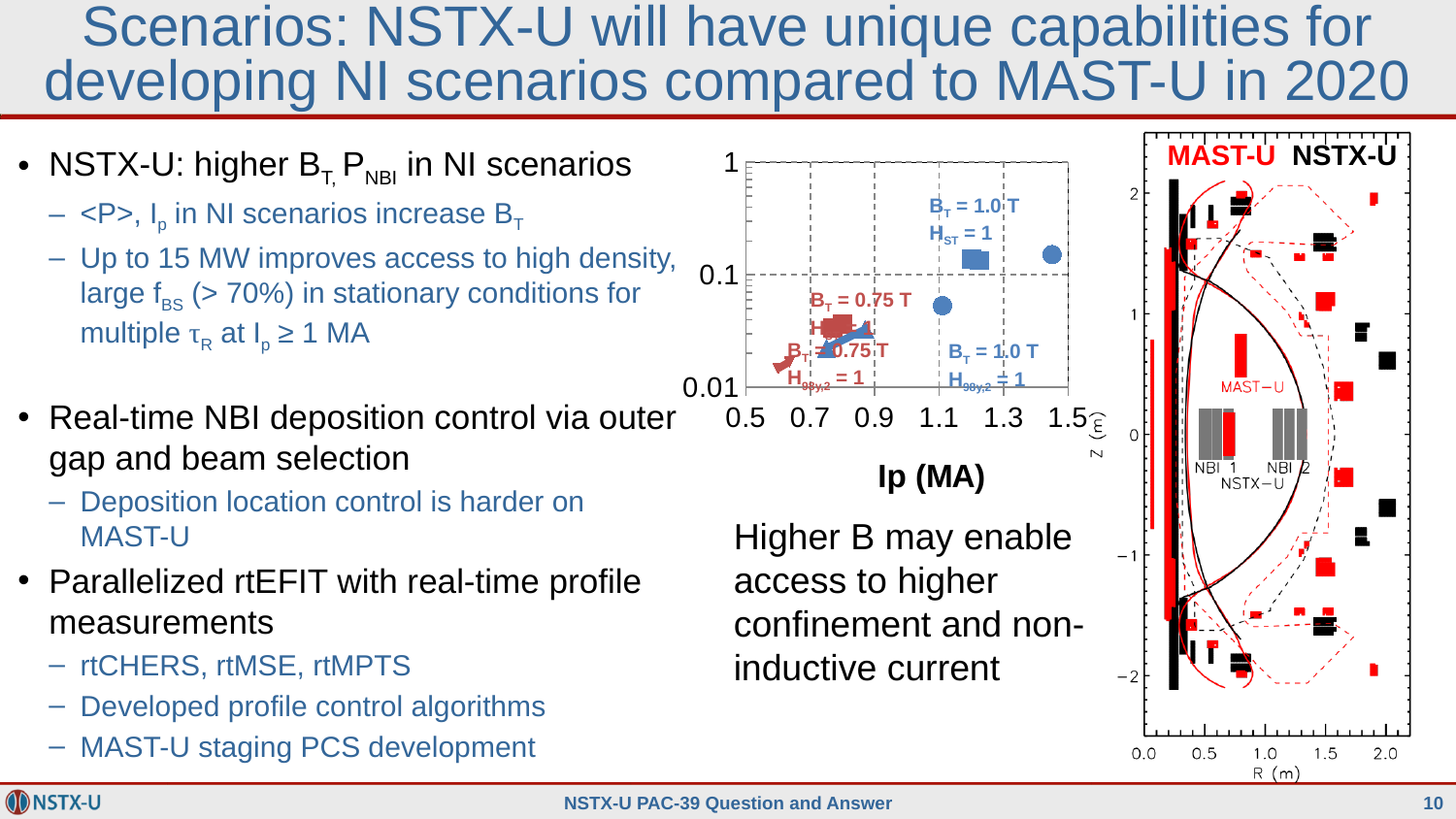
In the scatter chart, which colour of points is labeled with B_T = 1.0 T? blue In the scatter chart, is the rightmost blue point (near Ip = 1.4 MA) plotted greater or less than 0.1 on the y axis? greater What kind of chart is the plot with Ip (MA) on the x axis? scatter chart In the scatter chart, are the red points plotted greater or less than 0.01 on the y axis? greater In the scatter chart, are the red points labeled B_T = 0.75 T plotted greater or less than 0.1 on the y axis? less In the scatter chart, which group of points lies at higher Ip, the blue points or the red points? blue In the scatter chart, do the plotted values generally rise or fall as Ip increases? rise What is the title of the x axis of the scatter chart? Ip (MA)